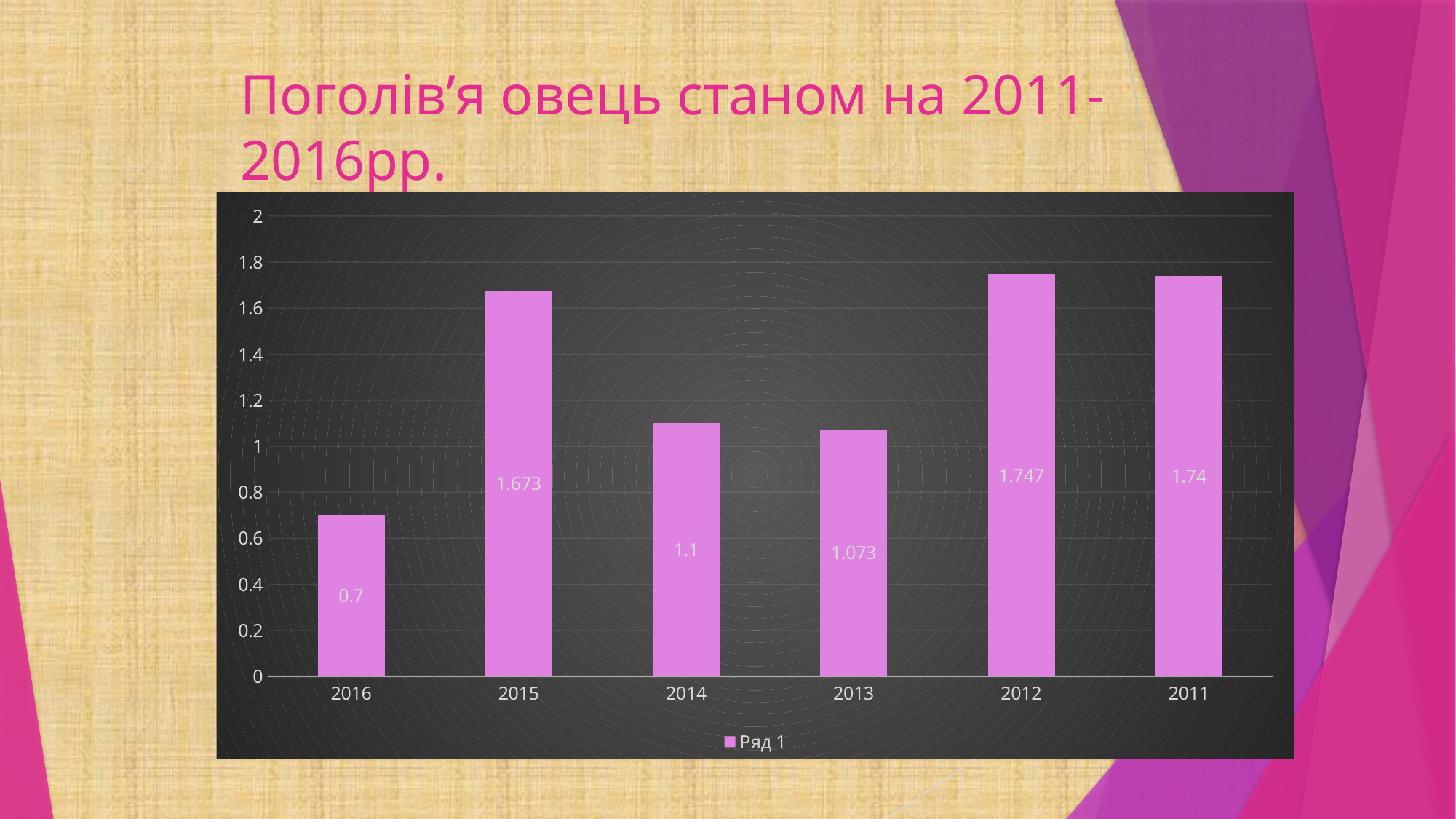
What is the value for 2015? 1.673 What is the value for 2012? 1.747 What kind of chart is shown on the slide? Bar chart What is the value for 2016? 0.7 How many years are shown on the x axis? 6 Which is larger, the value for 2014 or the value for 2013? 2014 What is the name of the series listed in the legend? Ряд 1 What is the difference between the values for 2015 and 2014? 0.573 Which year has the lowest value? 2016 Is the value for 2013 greater or less than 1.2? less Which year has the highest value? 2012 What is the value for 2013? 1.073